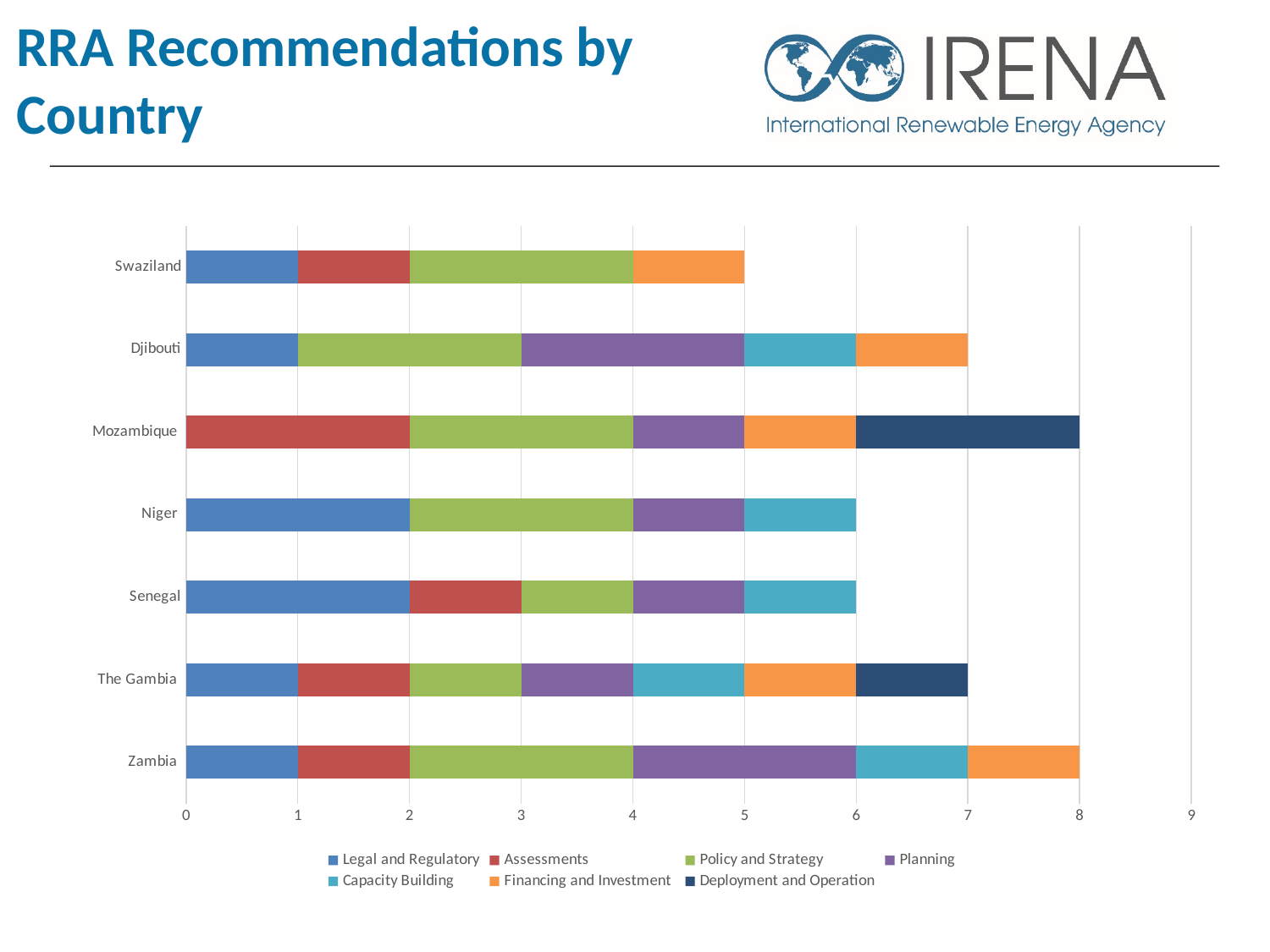
Is the total number of recommendations for Swaziland greater or less than 6? less Which legend entry is shown in dark navy blue? Deployment and Operation How many series does the legend list? 7 What is the total number of recommendations for Swaziland? 5 What is the total number of recommendations for Mozambique? 8 How many Legal and Regulatory recommendations does Niger have? 2 How many countries are shown on the chart? 7 Which has a larger total of recommendations, Mozambique or Swaziland? Mozambique What kind of chart is shown on the slide? Stacked bar chart What is the difference between the total recommendations for Mozambique and Swaziland? 3 Which country has the lowest total number of recommendations? Swaziland What is the total number of recommendations for The Gambia? 7